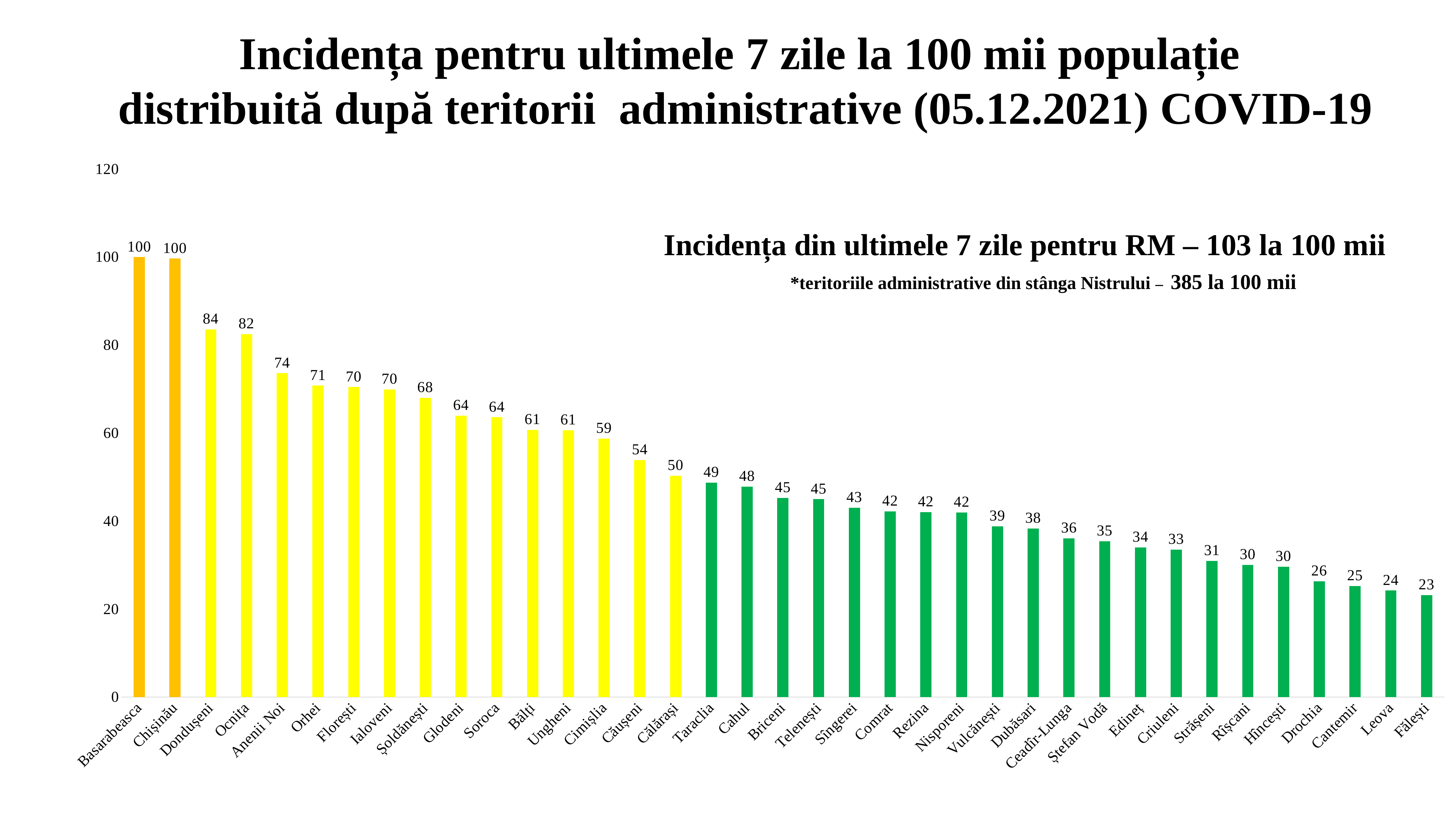
What is the difference between the values for Chișinău and Fălești? 77 How many territories are shown on the chart? 37 What is the value for Taraclia? 49 What kind of chart is shown on the slide? Bar chart What is the value for Hîncești? 30 Do the values rise or fall from left to right along the x axis? Fall Which has a larger value, Leova or Briceni? Briceni What is the difference between the values for Ocnița and Cahul? 34 Which has a larger value, Orhei or Comrat? Orhei Is the value for Anenii Noi greater or less than 60? greater What is the value for Dondușeni? 84 Which territory has the lowest value? Fălești